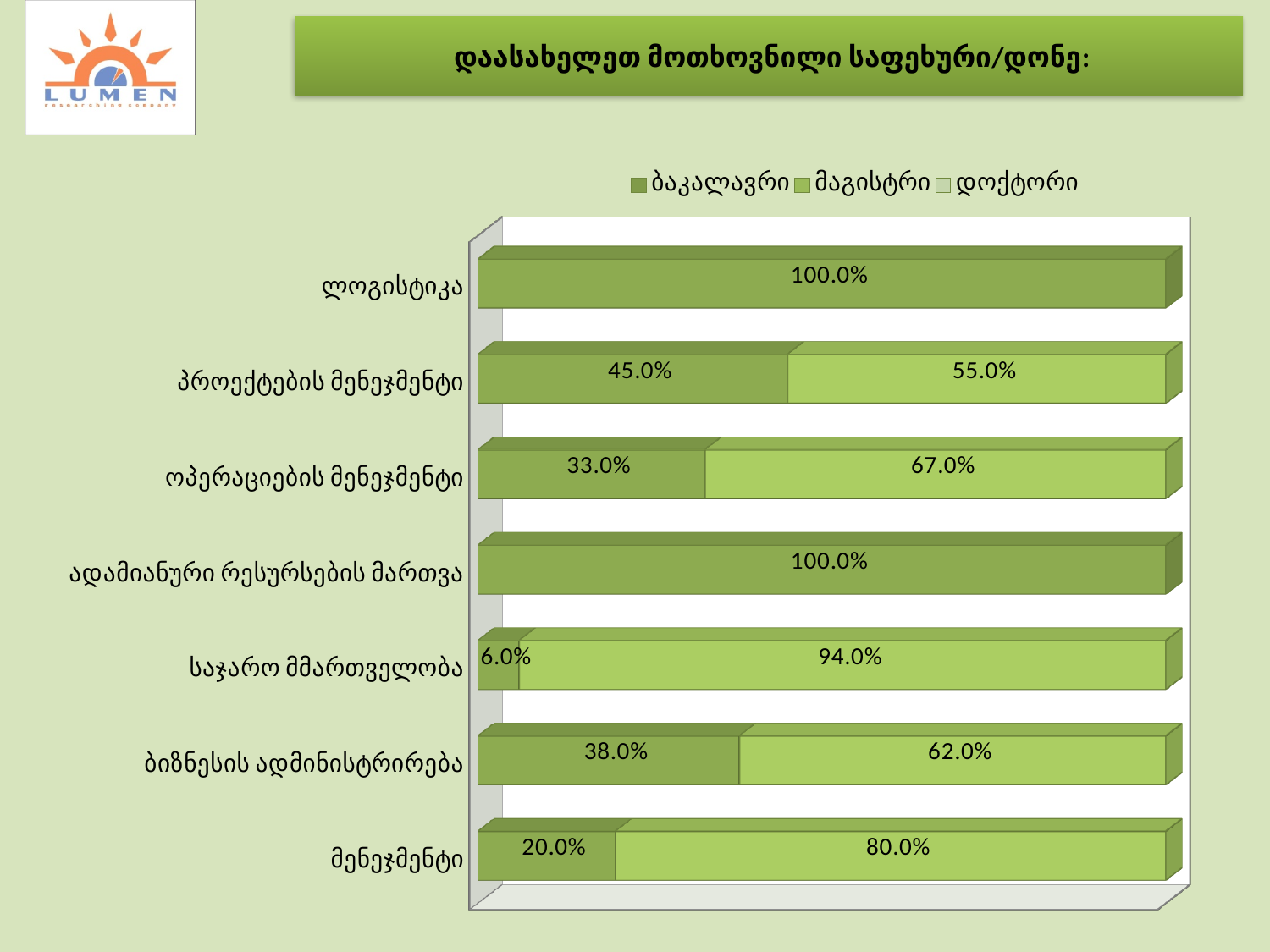
What is the მაგისტრი value for ოპერაციების მენეჯმენტი? 67.0% What is the difference between the მაგისტრი and ბაკალავრი values for ბიზნესის ადმინისტრირება? 24.0% What is the total of the stacked bar for ოპერაციების მენეჯმენტი? 100.0% Which category has the lowest ბაკალავრი value? საჯარო მმართველობა What kind of chart is shown on the slide? Stacked bar chart How many series does the legend list? 3 Which is larger for პროექტების მენეჯმენტი: the ბაკალავრი value or the მაგისტრი value? მაგისტრი What is the მაგისტრი value for საჯარო მმართველობა? 94.0% Which category has the highest მაგისტრი value? საჯარო მმართველობა How many categories are shown on the chart? 7 What is the ბაკალავრი value for პროექტების მენეჯმენტი? 45.0% What is the ბაკალავრი value for მენეჯმენტი? 20.0%